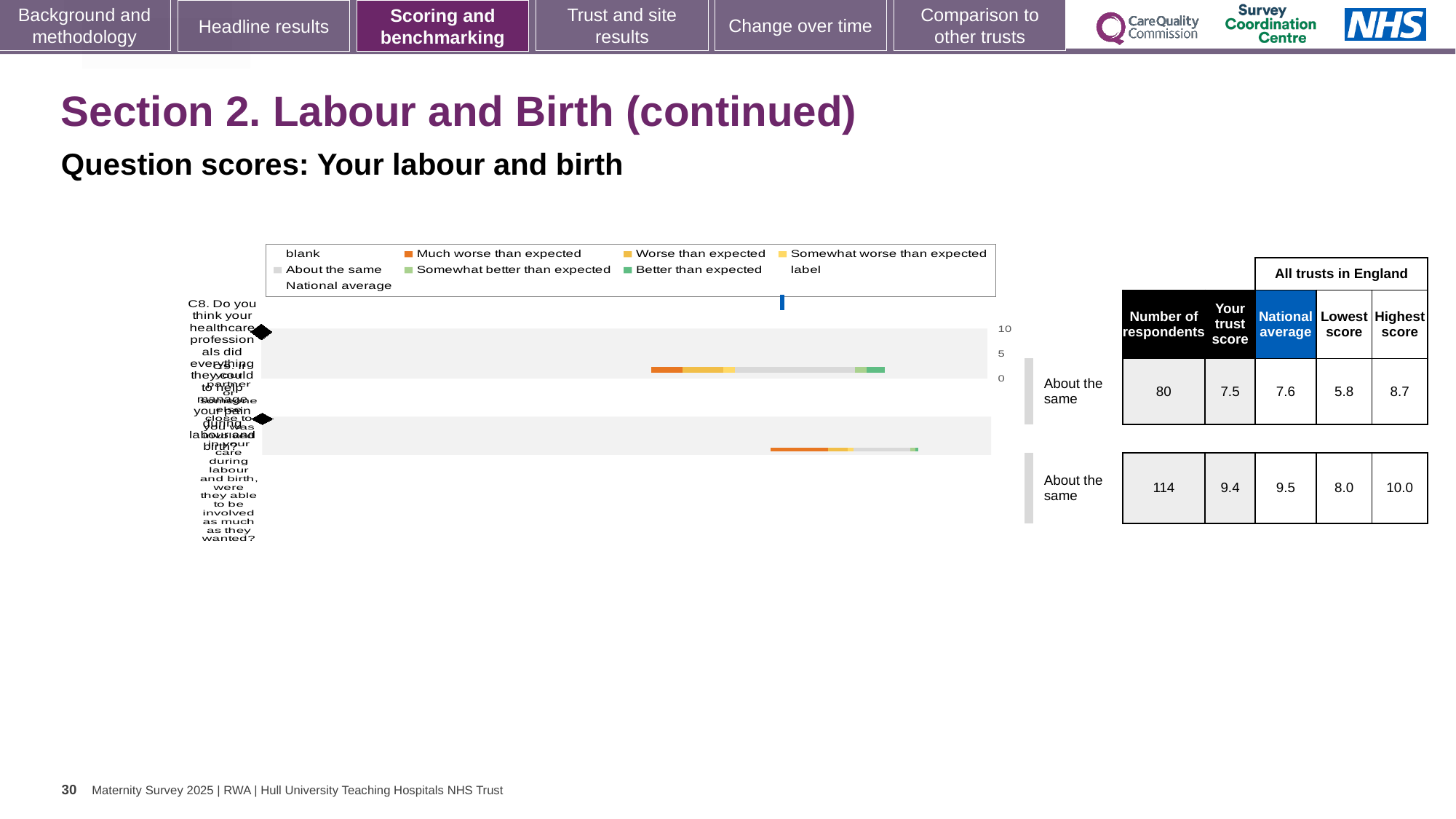
What colour does the legend use for 'Much worse than expected'? orange What is the 'Your trust score' value for the first question row (C8, managing pain during labour and birth)? 7.5 How many respondents are recorded for the second question row? 114 What is the national average for the first question row (C8)? 7.6 What kind of chart is shown on the slide? bar chart What benchmark category is shown for the first question row (C8)? About the same What is the highest score across all trusts in England for the second question row? 10.0 What is the difference between the highest score and the lowest score for the first question row (C8)? 2.9 What colour does the legend use for 'Better than expected'? green How many entries does the chart legend list? 9 Which question row has the higher trust score, the first or the second? the second How many question rows (bars) are plotted in the chart? 2